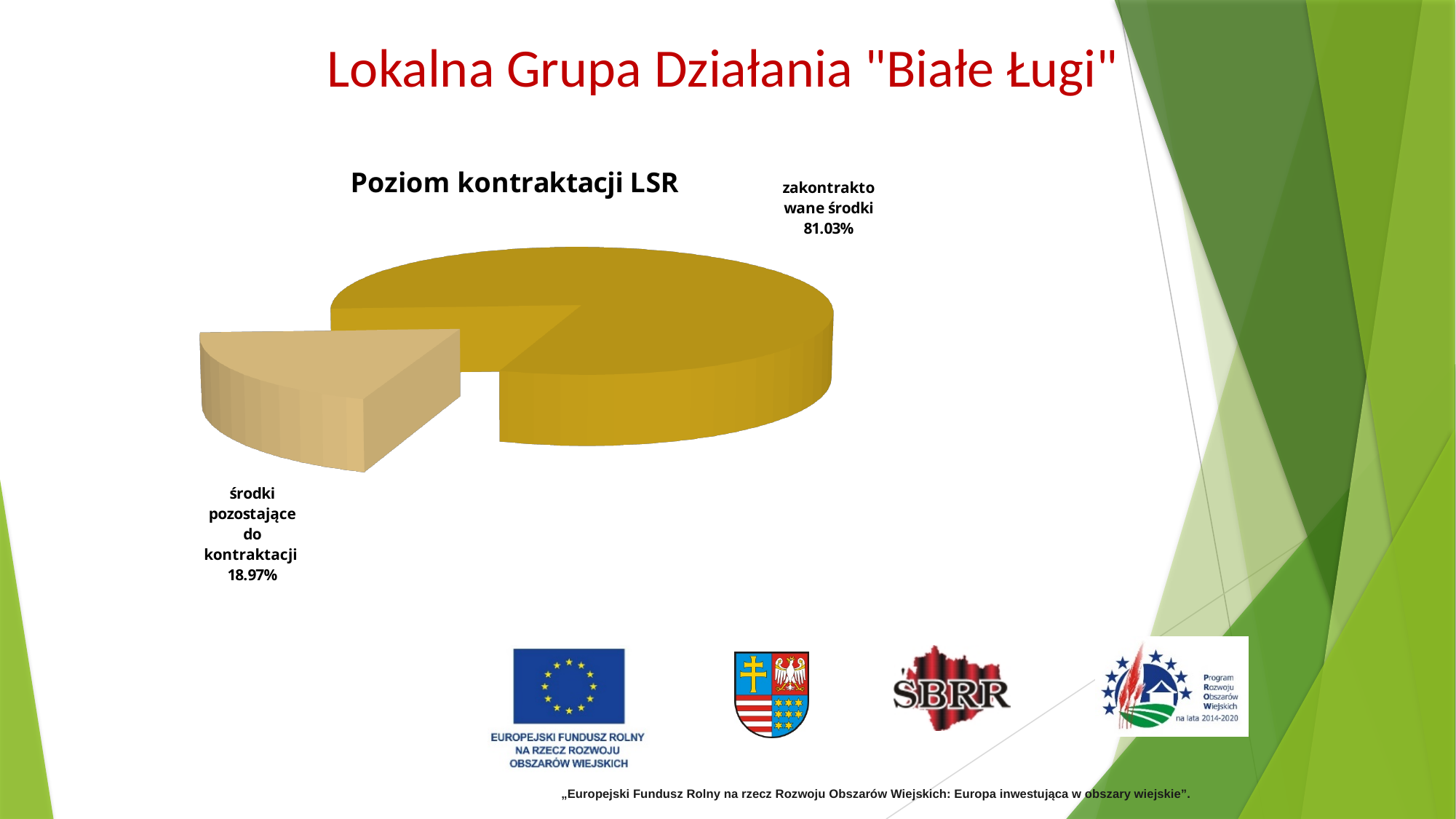
What is the title of the chart? Poziom kontraktacji LSR Which slice of the pie is the largest? zakontraktowane środki What is the difference in percentage points between the "zakontraktowane środki" slice and the "środki pozostające do kontraktacji" slice? 62.06 Which slice is pulled out (exploded) from the rest of the pie? środki pozostające do kontraktacji Which slice of the pie is the smallest? środki pozostające do kontraktacji What share of the pie is labelled "zakontraktowane środki"? 81.03% What share of the pie is labelled "środki pozostające do kontraktacji"? 18.97% Which is larger: the share for "zakontraktowane środki" or for "środki pozostające do kontraktacji"? zakontraktowane środki What kind of chart is shown on the slide? pie chart How many slices does the pie chart have? 2